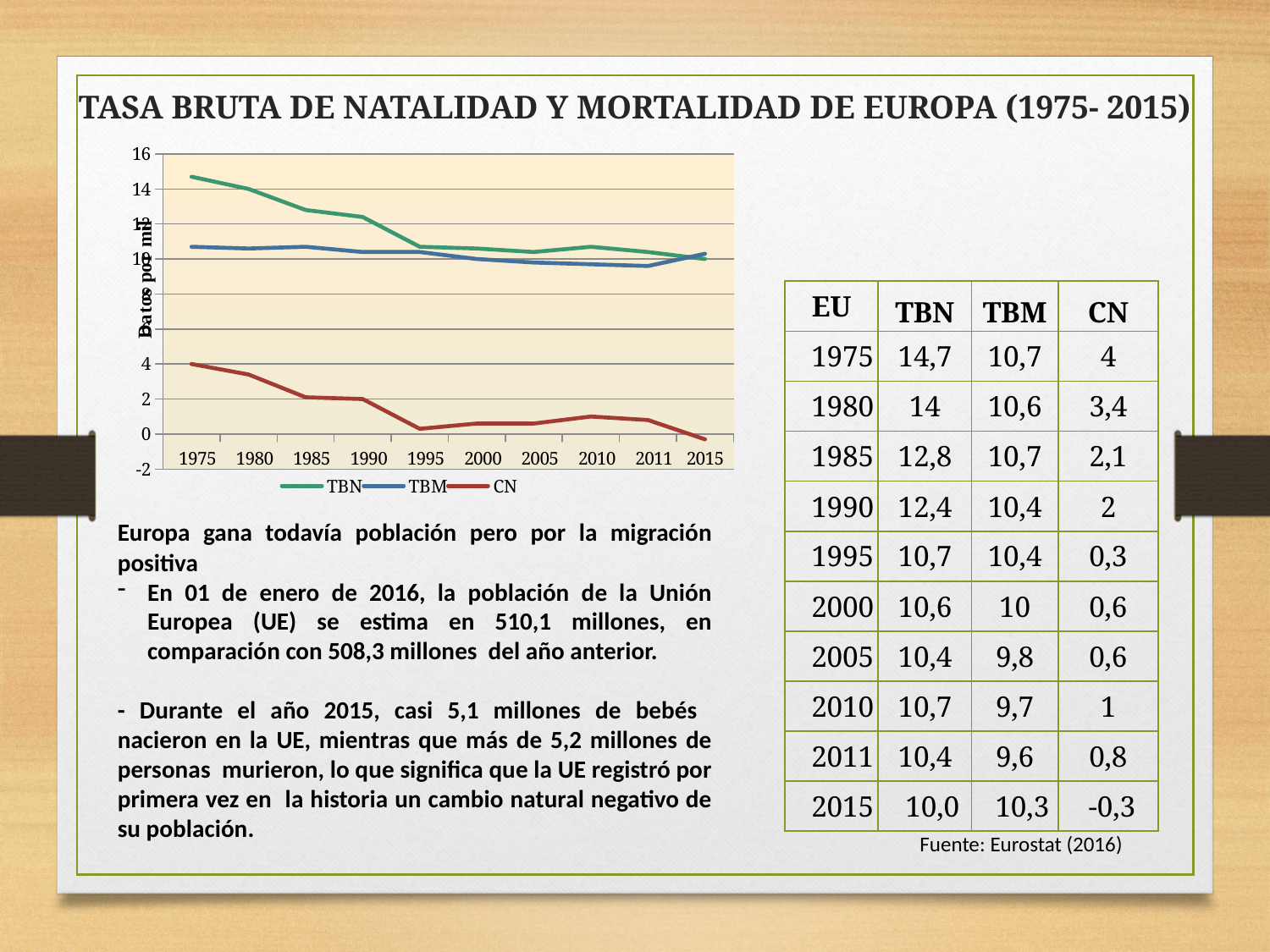
Is the value of TBM in 2005 greater or less than 12? less Which series has the highest value in 1975? TBN In which year does the CN series reach its lowest value? 2015 What is the value of TBM in 2015? 10,3 How many years are plotted along the x axis of the chart? 10 Which series is larger in 2015, TBN or TBM? TBM Does the TBN series rise or fall from 1975 to 2015? fall How many series does the chart legend list? 3 What is the value of TBN in 1975? 14,7 What is the difference between TBN and TBM in 1975? 4 What kind of chart is shown on the slide? line chart Is the value of CN in 1975 greater or less than 2? greater